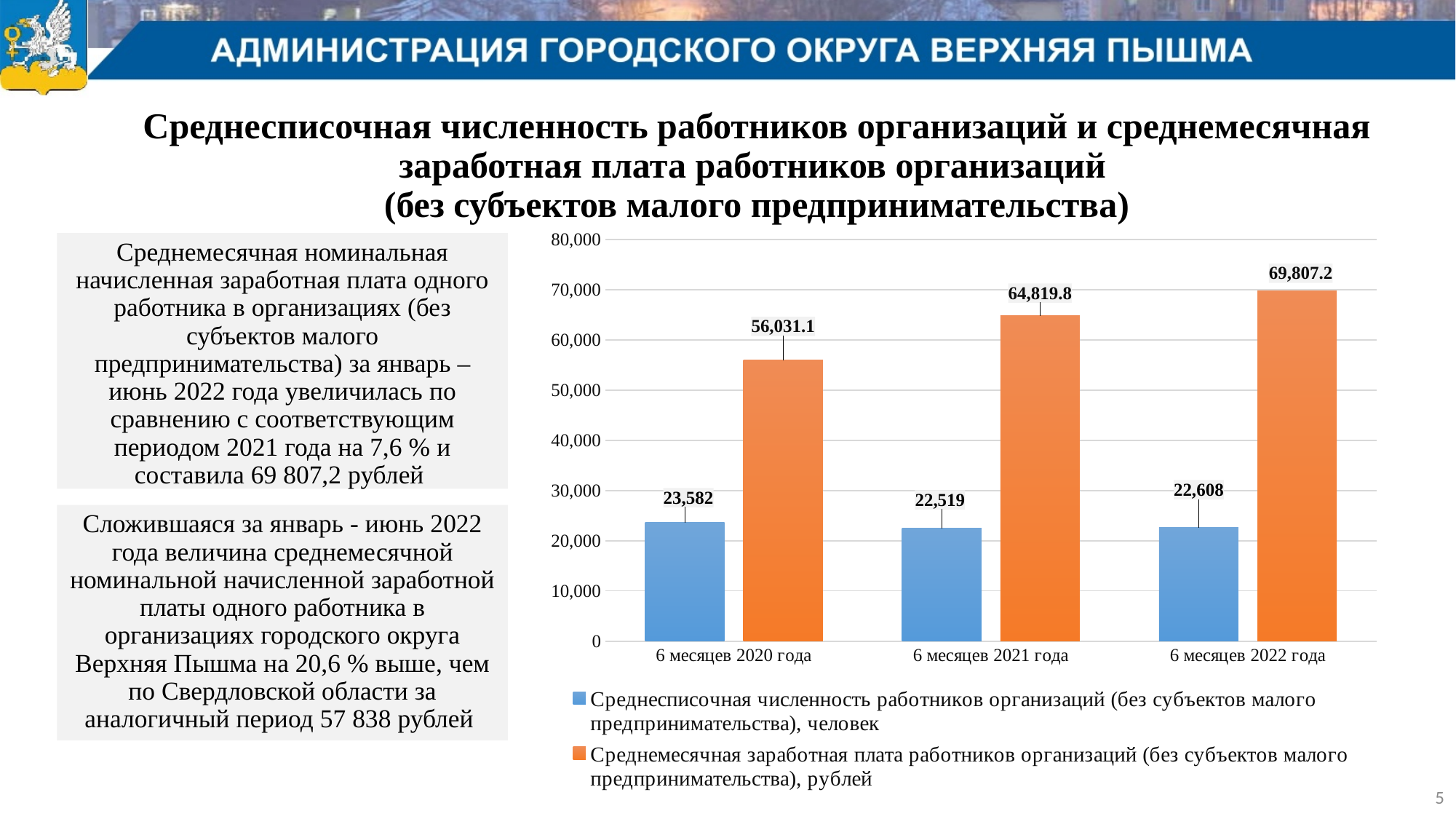
By how much did the average monthly salary increase from 6 месяцев 2021 года to 6 месяцев 2022 года? 4,987.4 In which period is the average monthly salary highest? 6 месяцев 2022 года What is the average monthly salary (Среднемесячная заработная плата) for 6 месяцев 2022 года? 69,807.2 How many series does the legend list? 2 What is the average headcount for 6 месяцев 2021 года? 22,519 What is the average headcount (Среднесписочная численность) for 6 месяцев 2020 года? 23,582 What is the difference in average headcount between 6 месяцев 2020 года and 6 месяцев 2022 года? 974 In which period is the average headcount lowest? 6 месяцев 2021 года Which is larger: the average headcount for 6 месяцев 2020 года or for 6 месяцев 2022 года? 6 месяцев 2020 года Does the average monthly salary rise or fall across the periods from 2020 to 2022? rise What is the average monthly salary for 6 месяцев 2021 года? 64,819.8 What kind of chart is shown on the slide? bar chart